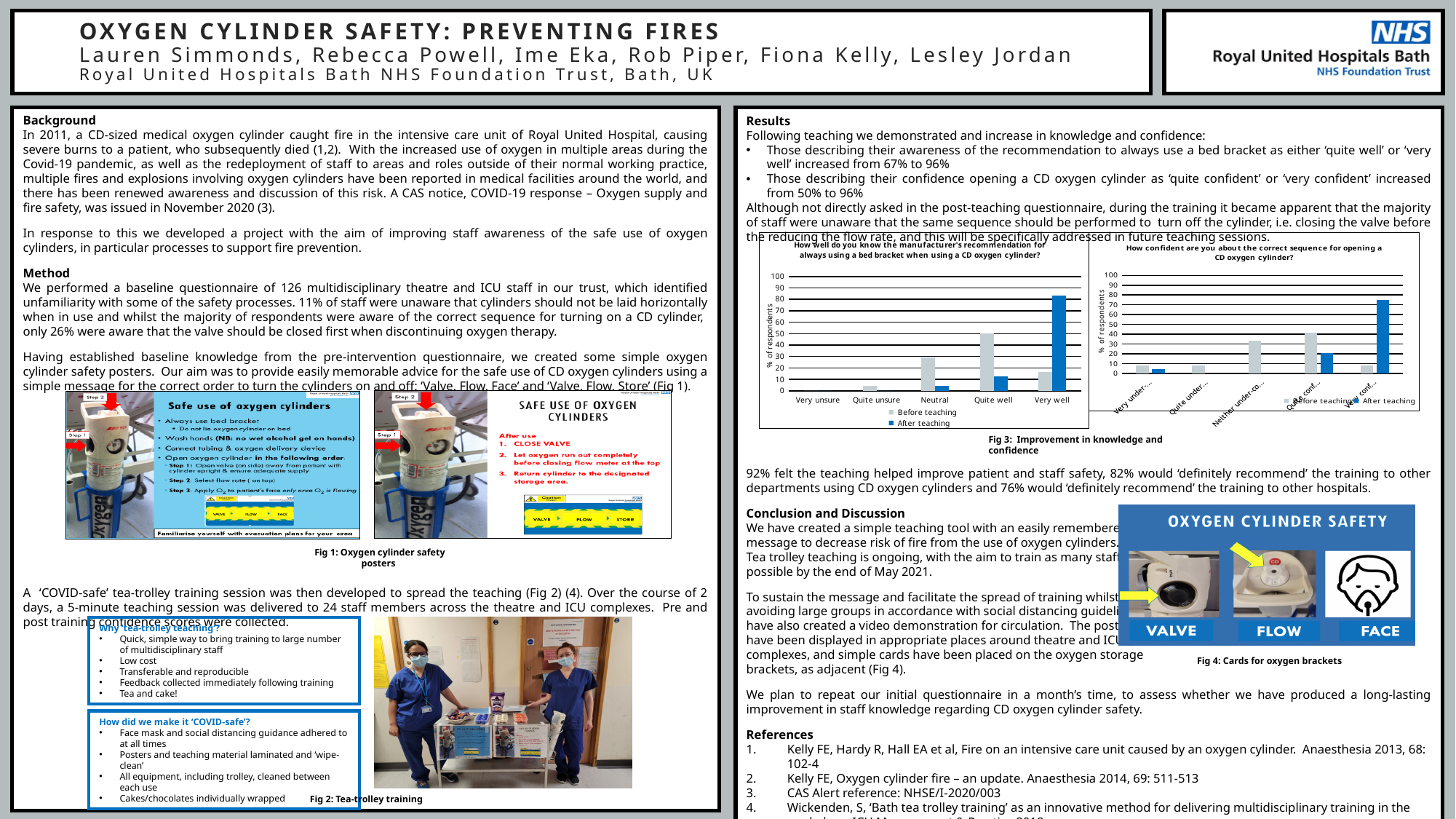
In the left chart in Fig 3, which category has the highest 'Before teaching' value? Quite well How many series does the legend of the left chart in Fig 3 list? 2 Which series in the left chart in Fig 3 is drawn in dark blue? After teaching In the left chart in Fig 3, which category has the highest 'After teaching' value? Very well In the right chart in Fig 3, is the tallest 'After teaching' bar greater or less than 60? greater What type of chart is the left chart in Fig 3 (about the bed bracket recommendation)? bar chart In the left chart in Fig 3, for 'Very well', which is larger: the 'Before teaching' or the 'After teaching' value? After teaching How many response categories are shown on the x axis of the left chart in Fig 3? 5 In the left chart in Fig 3, for 'Quite well', which is larger: the 'Before teaching' or the 'After teaching' value? Before teaching In the left chart in Fig 3, is the 'Before teaching' value for 'Neutral' greater or less than 40? less What is the y-axis label of the right chart in Fig 3 (about confidence in the opening sequence)? % of respondents In the left chart in Fig 3, is the 'After teaching' value for 'Very well' greater or less than 70? greater